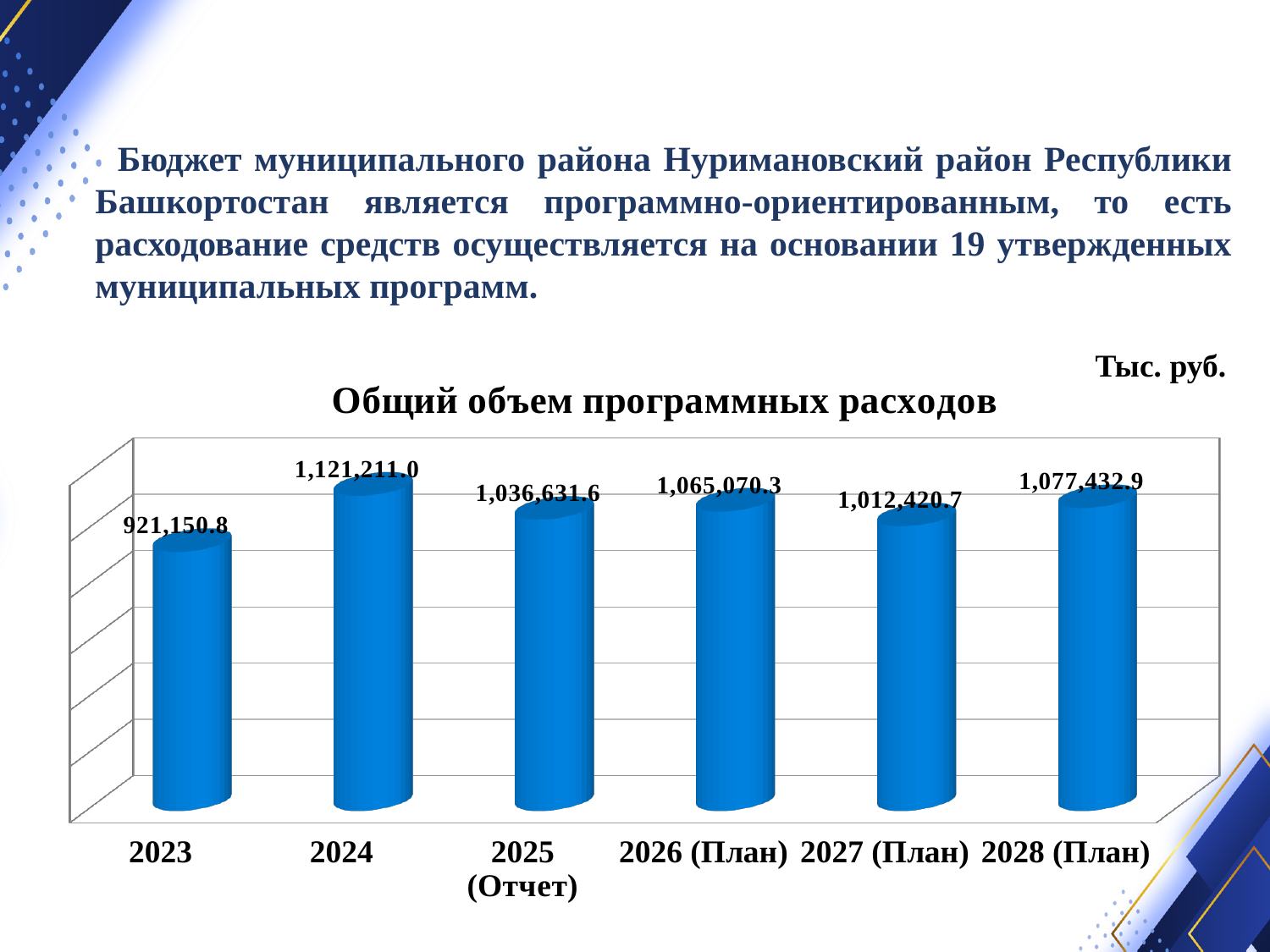
What is the difference between the values for 2028 (План) and 2027 (План)? 65,012.2 How many years (categories) are shown in the chart? 6 What unit of measurement is indicated for the chart? Тыс. руб. Which year has the lowest value in the chart? 2023 What is the value for 2024 in the chart? 1,121,211.0 What is the difference between the values for 2024 and 2023? 200,060.2 What is the value for 2027 (План) in the chart? 1,012,420.7 What kind of chart is shown on the slide? Bar chart What is the value for 2023 in the chart "Общий объем программных расходов"? 921,150.8 Which year has the highest value in the chart? 2024 Which is larger, the value for 2026 (План) or the value for 2025 (Отчет)? 2026 (План) What is the value for 2025 (Отчет) in the chart? 1,036,631.6